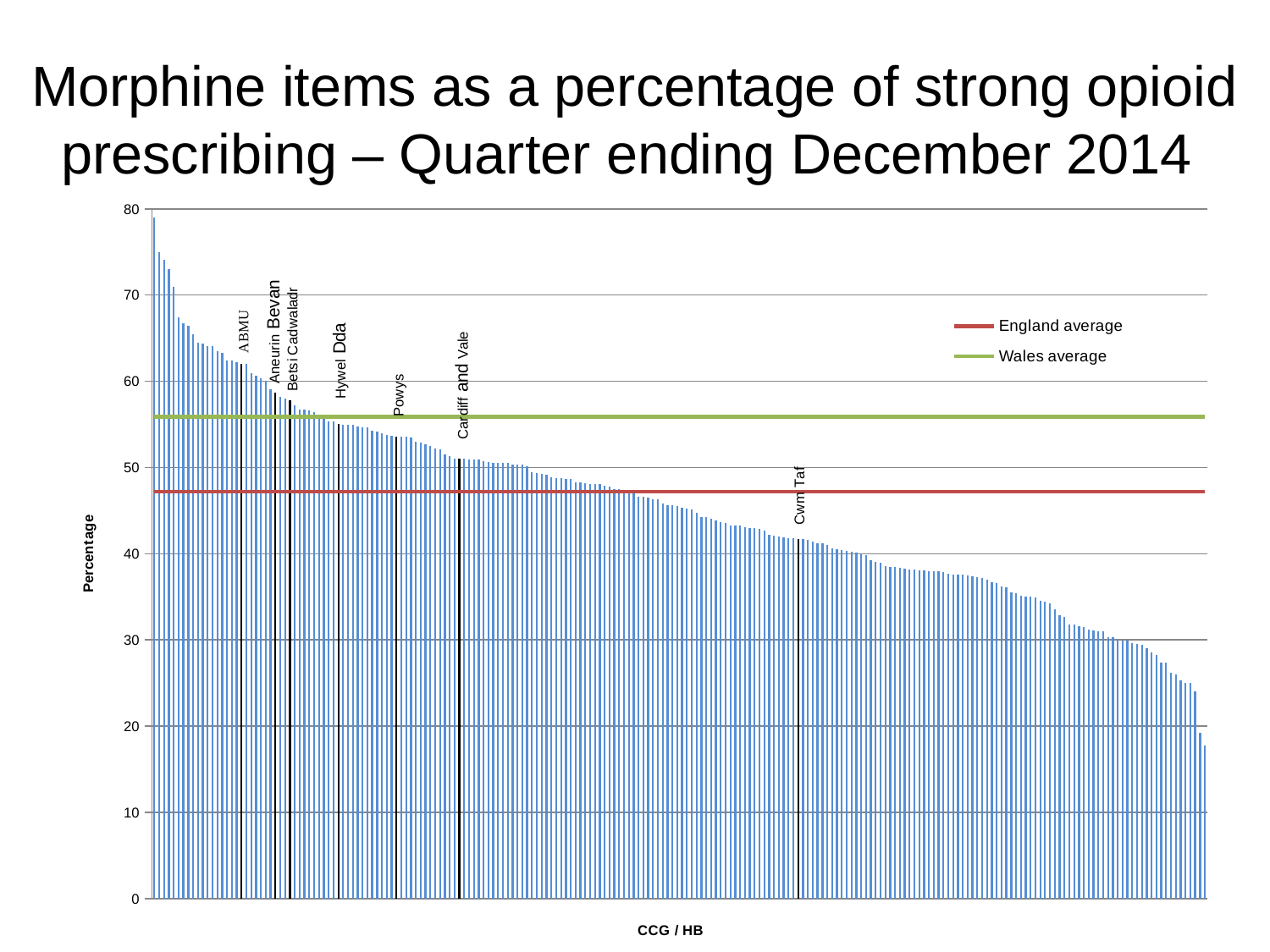
Is the value for Powys greater or less than 60? less Is the value for Cwm Taf greater or less than 50? less How many entries does the legend list? 2 Is the value for Cardiff and Vale greater or less than 60? less What is the title of the x axis? CCG / HB Do the bar values rise or fall from left to right along the x axis? Fall What kind of chart is shown on the slide? Bar chart Which of the labelled Welsh health boards has the highest value? ABMU Which of the labelled Welsh health boards has the lowest value? Cwm Taf Which is larger, the value for Cardiff and Vale or the value for Cwm Taf? Cardiff and Vale